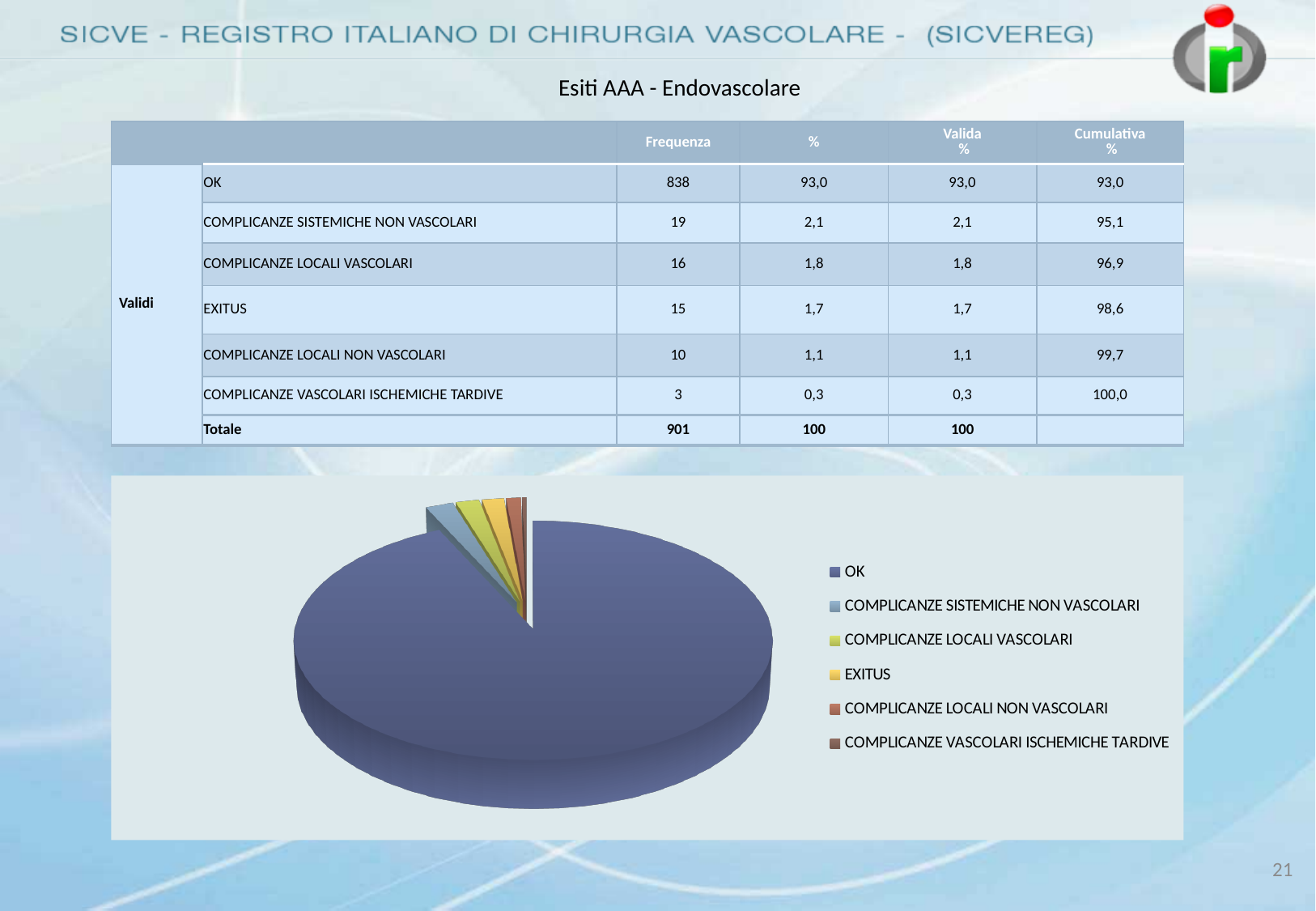
What kind of chart is shown on the slide? pie chart Which category has the largest slice in the pie chart? OK Which slice is larger in the pie chart: OK or EXITUS? OK How many slices does the pie chart have? 6 How many entries does the pie chart legend list? 6 According to the table, what percentage share does the OK slice represent? 93,0 What colour is the OK slice in the pie chart? blue According to the table, what percentage share does the EXITUS slice represent? 1,7 What is the difference in frequency between COMPLICANZE SISTEMICHE NON VASCOLARI and COMPLICANZE VASCOLARI ISCHEMICHE TARDIVE, as given in the table? 16 Which category has the smallest slice in the pie chart? COMPLICANZE VASCOLARI ISCHEMICHE TARDIVE According to the table, what is the frequency for OK, the largest slice of the pie chart? 838 What is the total frequency across all categories shown in the pie chart, as given in the table? 901